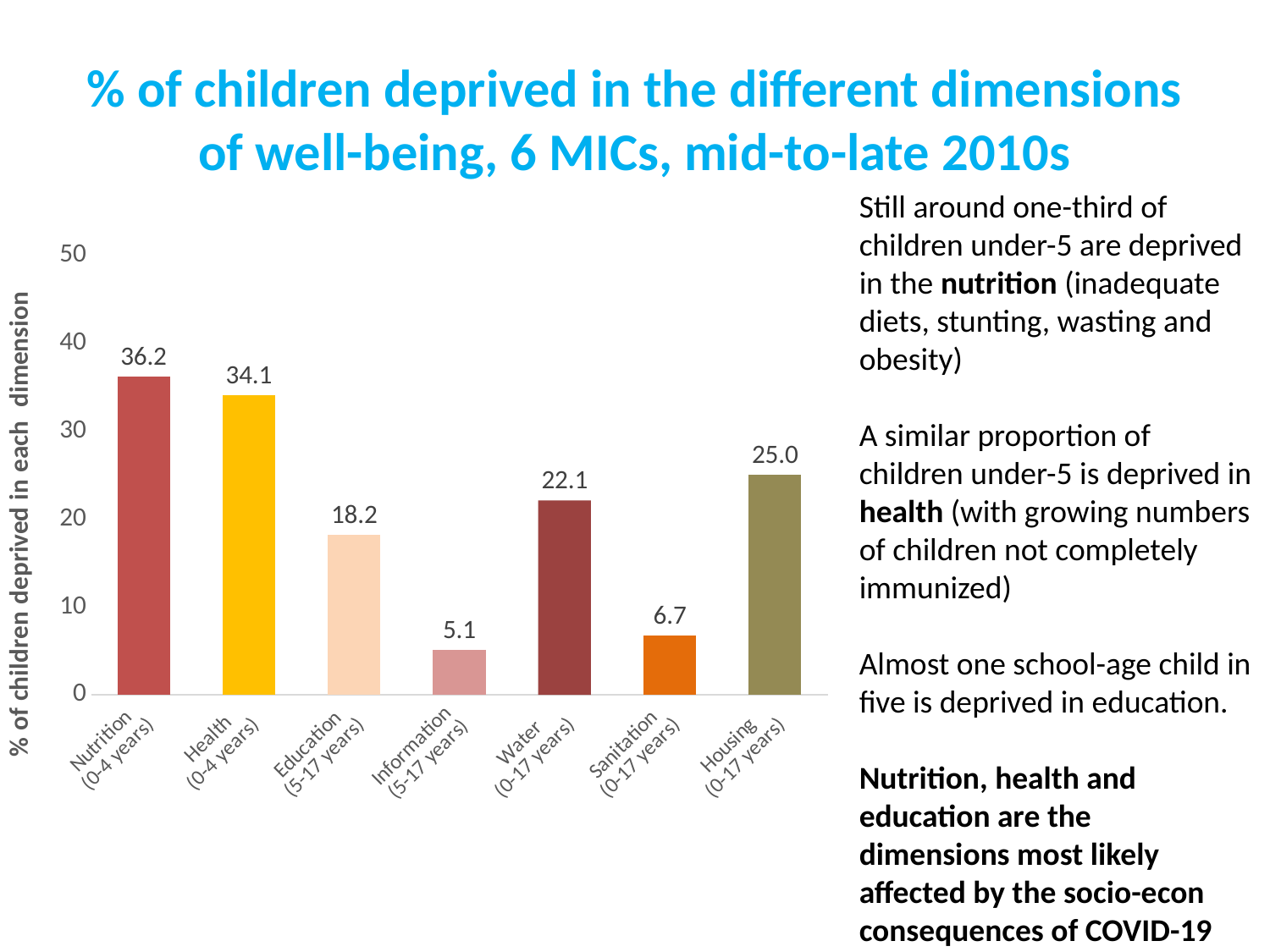
What is the difference between the values for Nutrition (0-4 years) and Health (0-4 years)? 2.1 What kind of chart is shown on the slide? bar chart What is the value for Education (5-17 years)? 18.2 What is the value for Housing (0-17 years)? 25.0 Is the value for Health (0-4 years) greater or less than 30? greater What is the difference between the values for Water (0-17 years) and Sanitation (0-17 years)? 15.4 What is the y-axis label of the chart? % of children deprived in each dimension Which dimension has the lowest percentage of children deprived? Information (5-17 years) Which dimension has the highest percentage of children deprived? Nutrition (0-4 years) What is the value for Nutrition (0-4 years)? 36.2 How many dimensions are shown on the x axis? 7 Which is larger, the value for Housing (0-17 years) or the value for Water (0-17 years)? Housing (0-17 years)